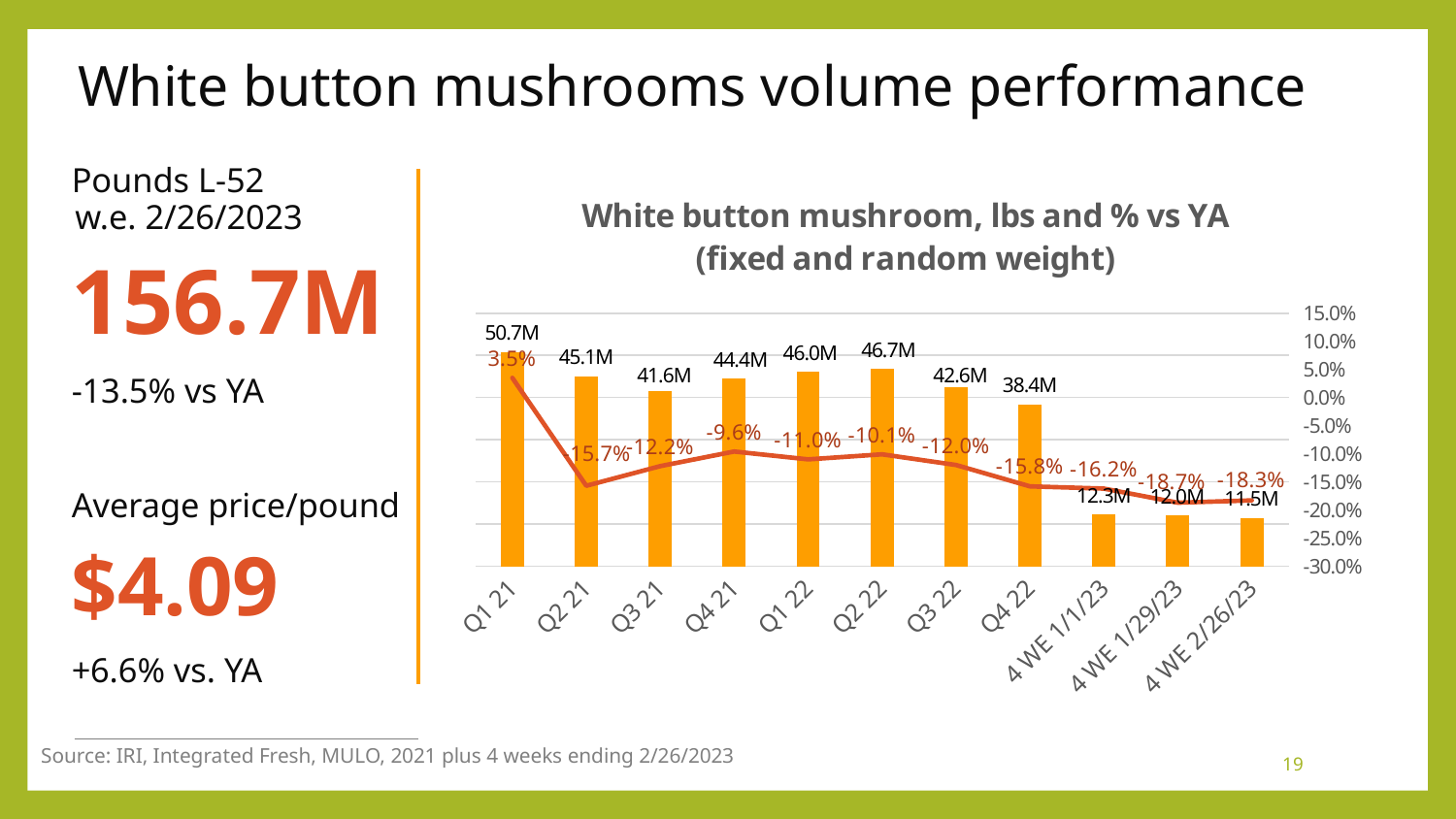
Is the % vs YA value for Q2 21 greater or less than -10.0%? less Which period has the highest volume in pounds? Q1 21 How many periods are shown on the x axis? 11 Which has the larger volume in pounds, Q2 21 or Q1 22? Q1 22 What is the % vs YA value for Q4 21? -9.6% Which period has the lowest % vs YA value? 4 WE 1/29/23 What is the title of the chart? White button mushroom, lbs and % vs YA (fixed and random weight) What is the % vs YA value for 4 WE 1/29/23? -18.7% What is the volume in pounds for the 4 WE 2/26/23 period? 11.5M What is the volume in pounds for Q1 21? 50.7M What is the difference in pounds between Q2 22 and Q3 22? 4.1M What kind of chart is shown on the slide? Combined bar and line chart